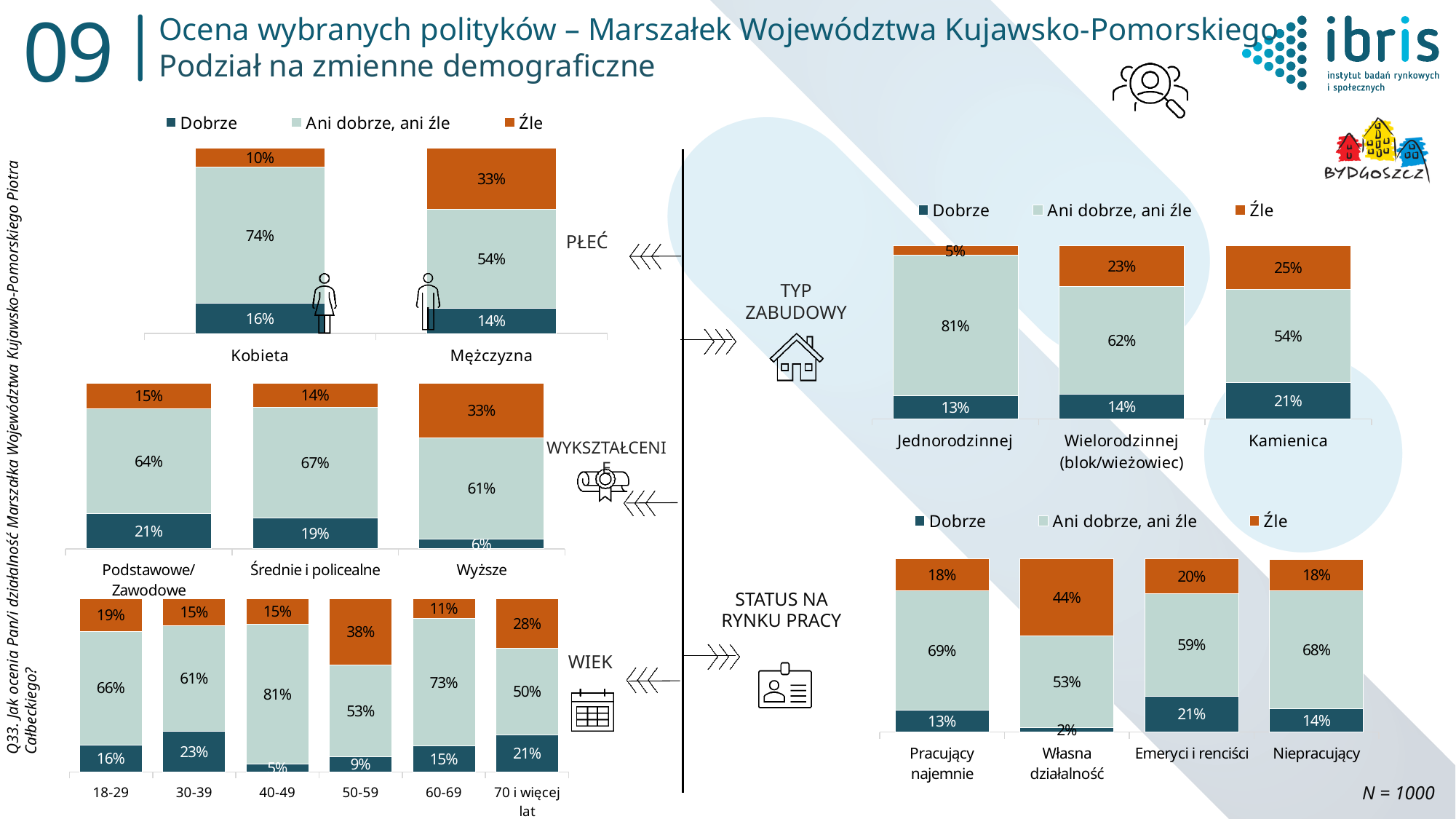
In the PŁEĆ chart, what percentage of men (Mężczyzna) answered "Źle"? 33% In the WIEK chart, how many age groups are shown? 6 In the STATUS NA RYNKU PRACY chart, is the "Źle" share larger for Własna działalność or for Emeryci i renciści? Własna działalność In the PŁEĆ chart, what is the difference between the "Ani dobrze, ani źle" share for Kobieta and for Mężczyzna? 20 percentage points In the WYKSZTAŁCENIE chart, which education group has the lowest "Dobrze" share? Wyższe In the WYKSZTAŁCENIE chart, what is the "Ani dobrze, ani źle" value for Średnie i policealne? 67% How many series does the legend of the STATUS NA RYNKU PRACY chart list? 3 In the WIEK chart, what is the "Ani dobrze, ani źle" value for the 40-49 group? 81% In the TYP ZABUDOWY chart, what is the "Źle" value for Jednorodzinnej? 5% In the WIEK chart, which age group has the highest "Źle" share? 50-59 In the TYP ZABUDOWY chart, which building type has the highest "Dobrze" share? Kamienica In the PŁEĆ chart, what percentage of women (Kobieta) answered "Dobrze"? 16%